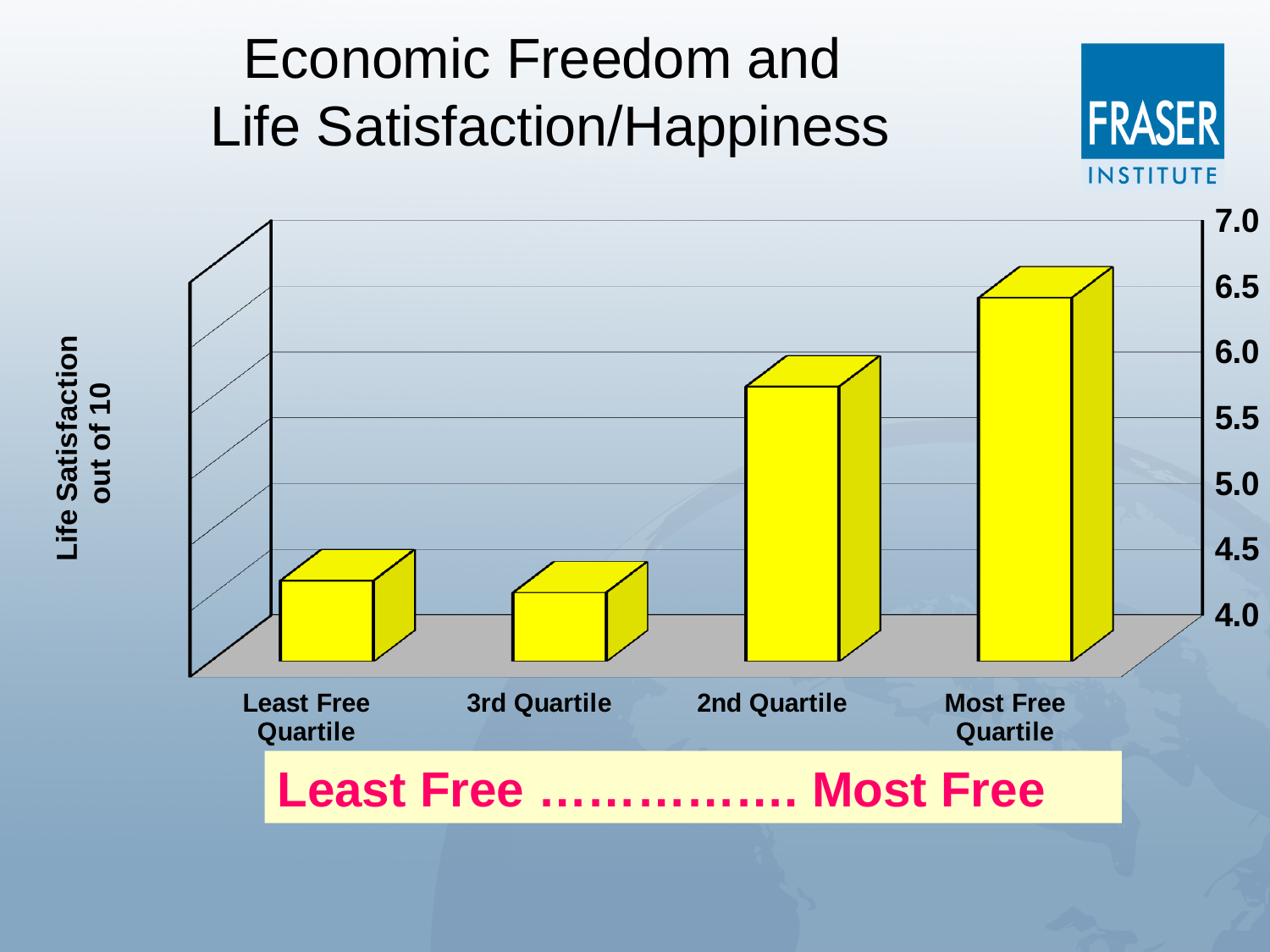
Which has a larger life satisfaction value, the Least Free Quartile or the 2nd Quartile? 2nd Quartile Is the value for the Most Free Quartile greater or less than 6.0? greater Is the value for the 2nd Quartile greater or less than 5.5? greater Is the value for the Most Free Quartile greater or less than 7.0? less Which quartile has the highest life satisfaction value? Most Free Quartile Do the values generally rise or fall moving from the Least Free Quartile to the Most Free Quartile? rise Which has a larger life satisfaction value, the 2nd Quartile or the Most Free Quartile? Most Free Quartile How many categories (quartiles) are plotted on the chart? 4 What kind of chart is shown on the slide? bar chart What is the label on the vertical axis of the chart? Life Satisfaction out of 10